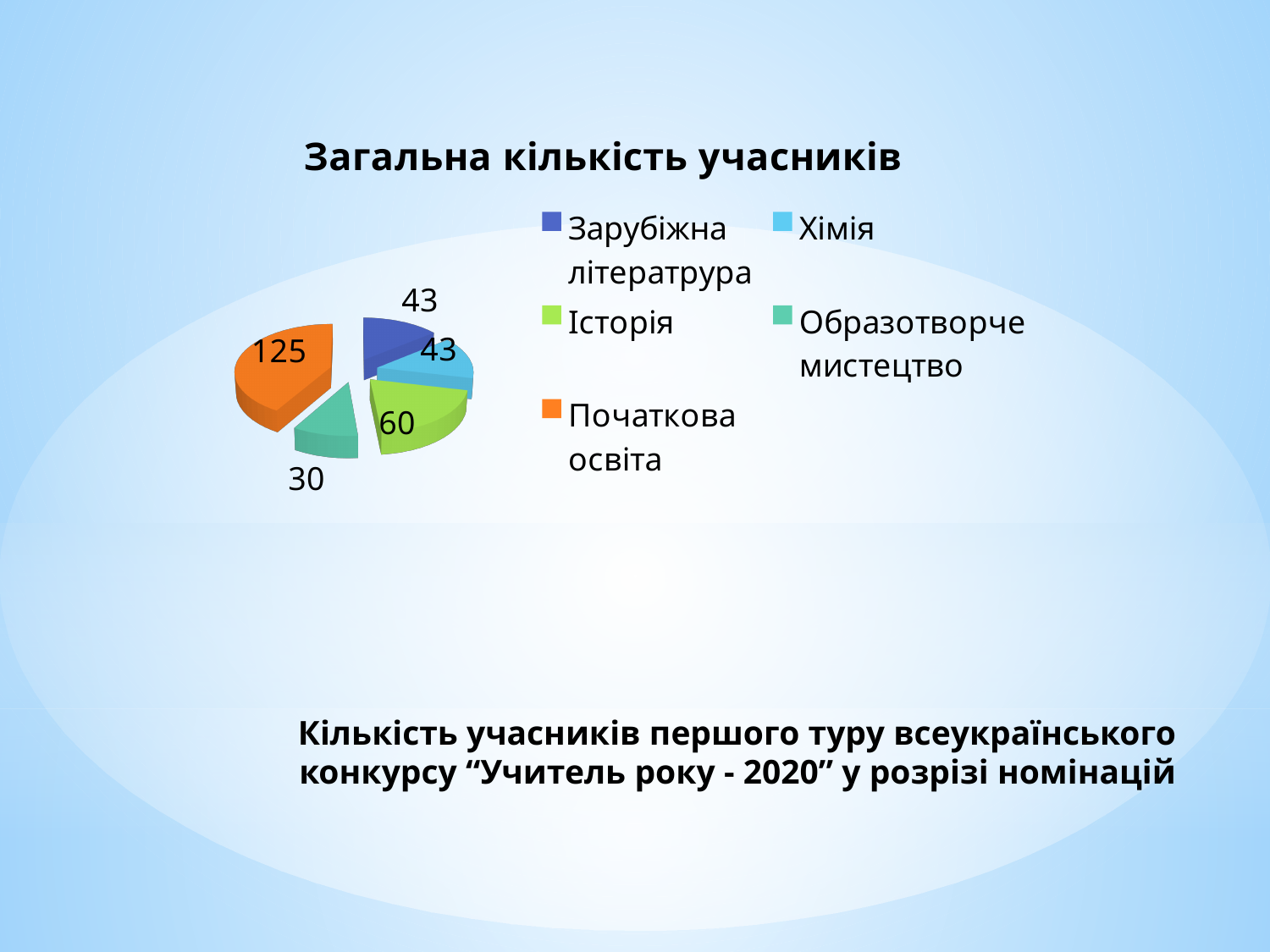
What type of chart is shown on the slide? Pie chart How many entries does the legend list? 5 What is the value for Історія? 60 What is the value for Початкова освіта? 125 How many slices does the pie chart have? 5 Which category has the smallest slice? Образотворче мистецтво What is the title of the chart? Загальна кількість учасників What is the value for Хімія? 43 What is the difference between the values for Початкова освіта and Історія? 65 Which is larger, the value for Історія or the value for Зарубіжна літератрура? Історія Which category has the largest slice? Початкова освіта What is the value for Образотворче мистецтво? 30